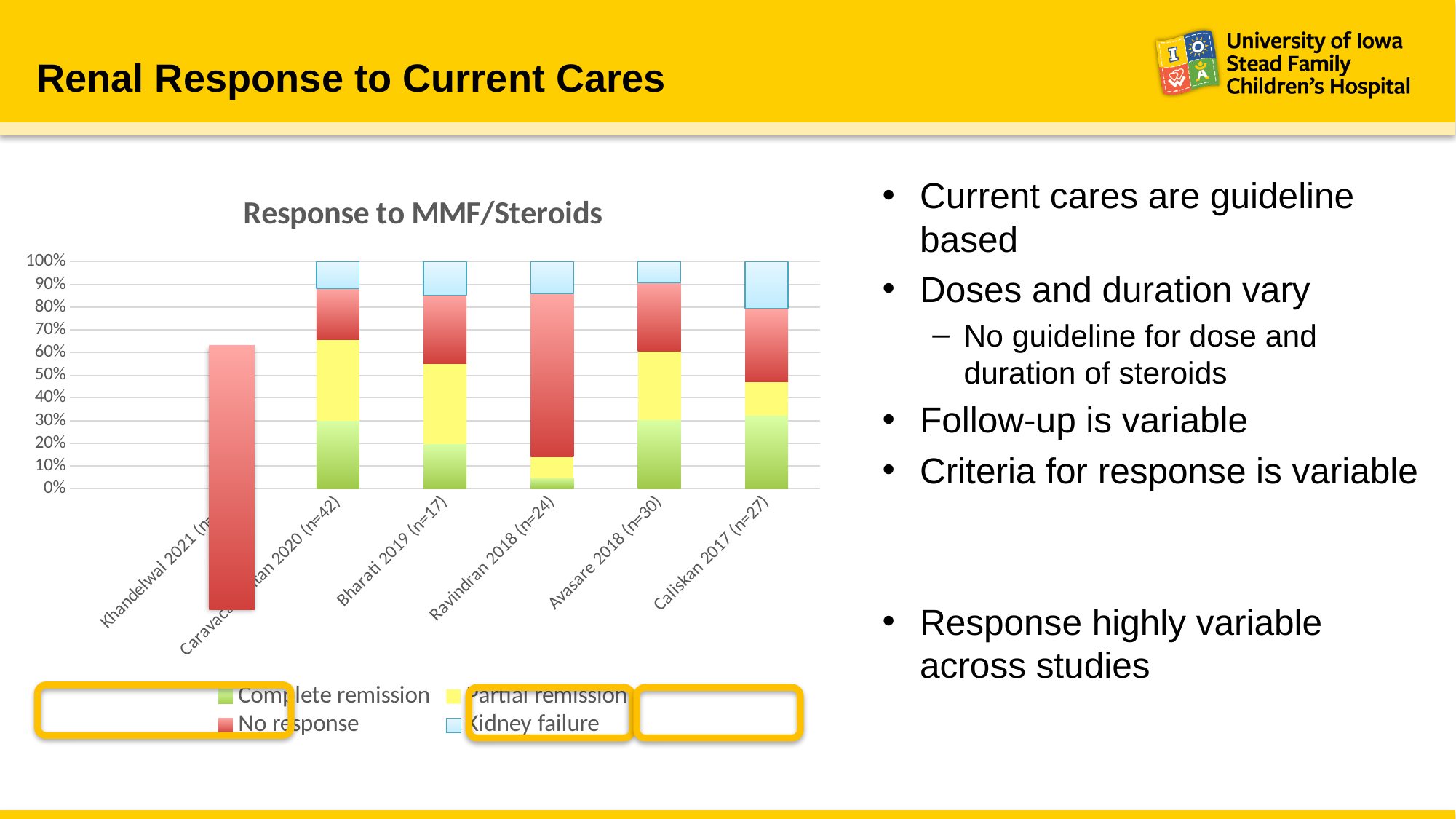
Which legend entry is shown in light blue? Kidney failure Which study has the smallest Partial remission segment? Ravindran 2018 (n=24) What kind of chart is shown on the slide? Stacked bar chart How many series does the chart legend list? 4 How many studies (categories) are shown on the x axis of the chart? 6 Which has a larger Complete remission segment, Bharati 2019 (n=17) or Avasare 2018 (n=30)? Avasare 2018 (n=30) Which study has the smallest Complete remission segment? Ravindran 2018 (n=24) Which study has the largest Kidney failure segment? Caliskan 2017 (n=27) Is the Complete remission value for Ravindran 2018 (n=24) greater or less than 10%? less What is the title of the chart? Response to MMF/Steroids Which study has the largest No response segment? Ravindran 2018 (n=24) Is the Kidney failure share for Ravindran 2018 (n=24) greater or less than 20%? less